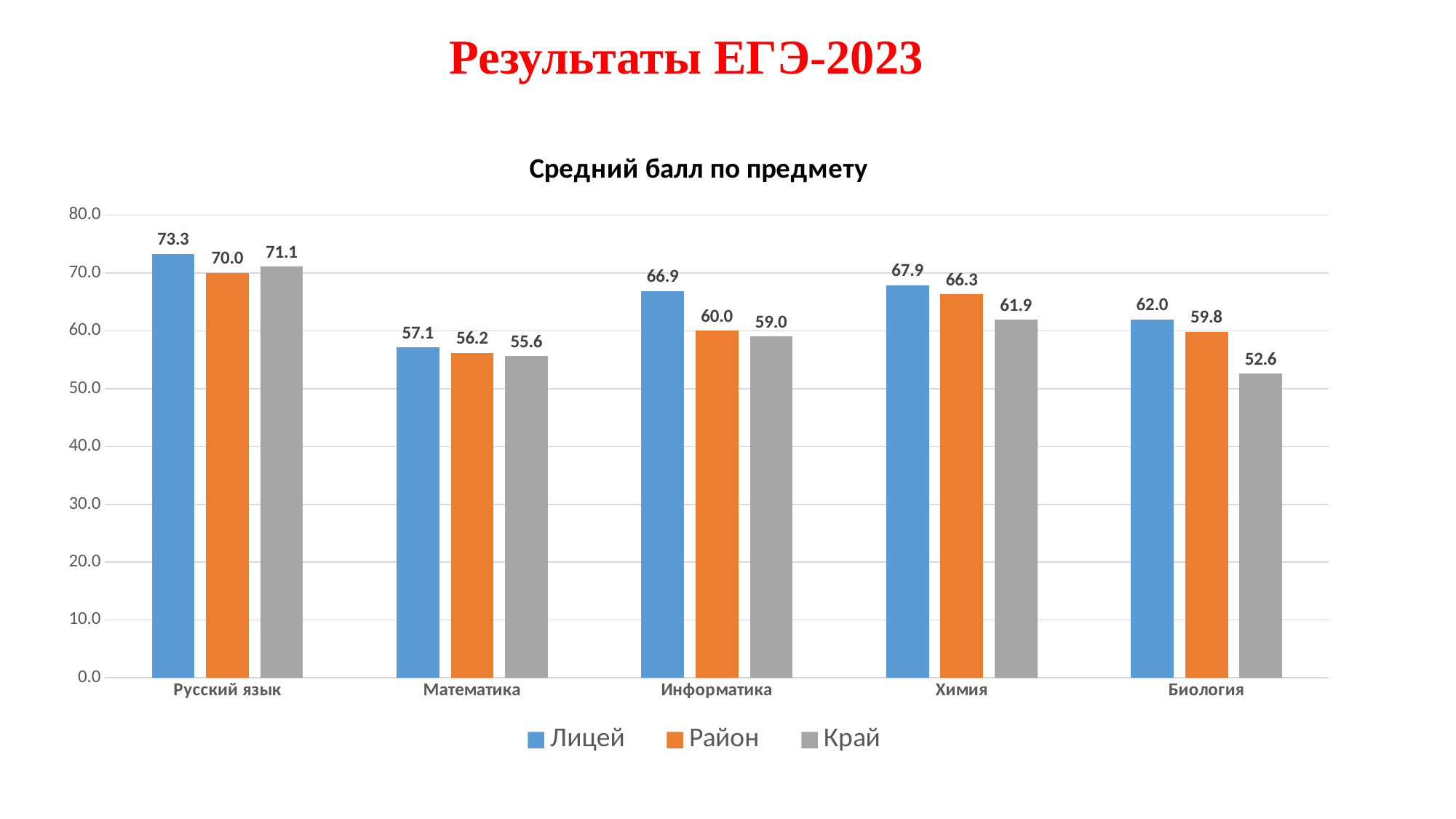
What is the value for Лицей in Русский язык? 73.3 What is the value for Район in Информатика? 60.0 Which subject has the highest value for Лицей? Русский язык How many series does the legend list? 3 How many subjects are shown on the x axis? 5 What kind of chart is shown? bar chart What is the value for Край in Биология? 52.6 Which is larger in Русский язык: Район or Край? Край What is the title of the chart? Средний балл по предмету Is the value for Лицей in Химия greater or less than 60.0? greater Which subject has the lowest value for Край? Биология What is the difference between Лицей and Край in Биология? 9.4